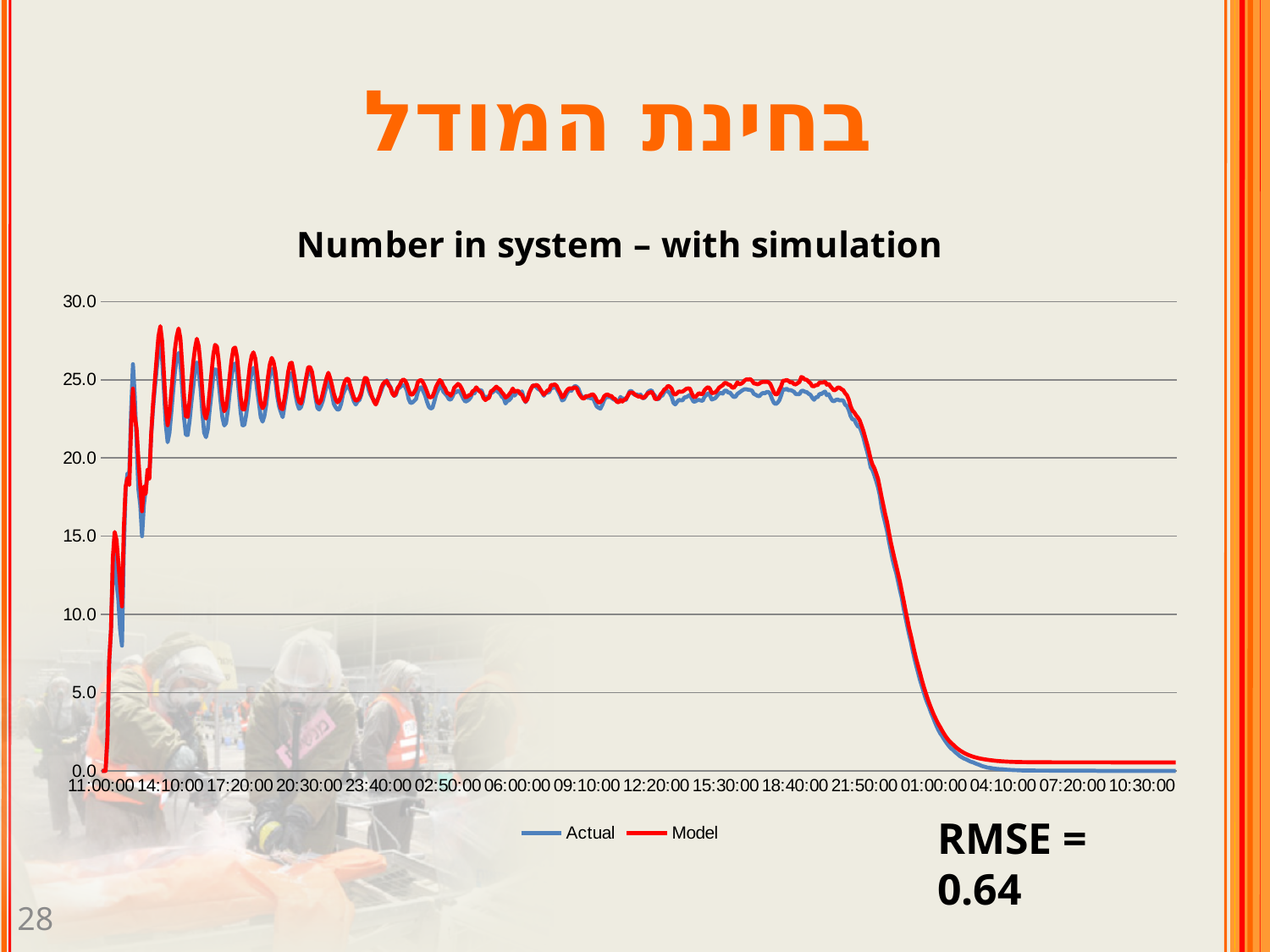
What kind of chart is shown on the slide? line chart Is the value of the Model series at 06:00:00 greater or less than 15.0? greater Is the value of the Model series at 10:30:00 greater or less than 5.0? less What is the highest value shown on the vertical axis? 30.0 Is the value of the Actual series at 07:20:00 greater or less than 10.0? less Which series is drawn in red? Model Do the values of the Actual series rise or fall between 21:50:00 and 04:10:00? fall What is the title of the chart? Number in system – with simulation Do the values of the Model series rise or fall between 11:00:00 and 14:10:00? rise How many series does the legend list? 2